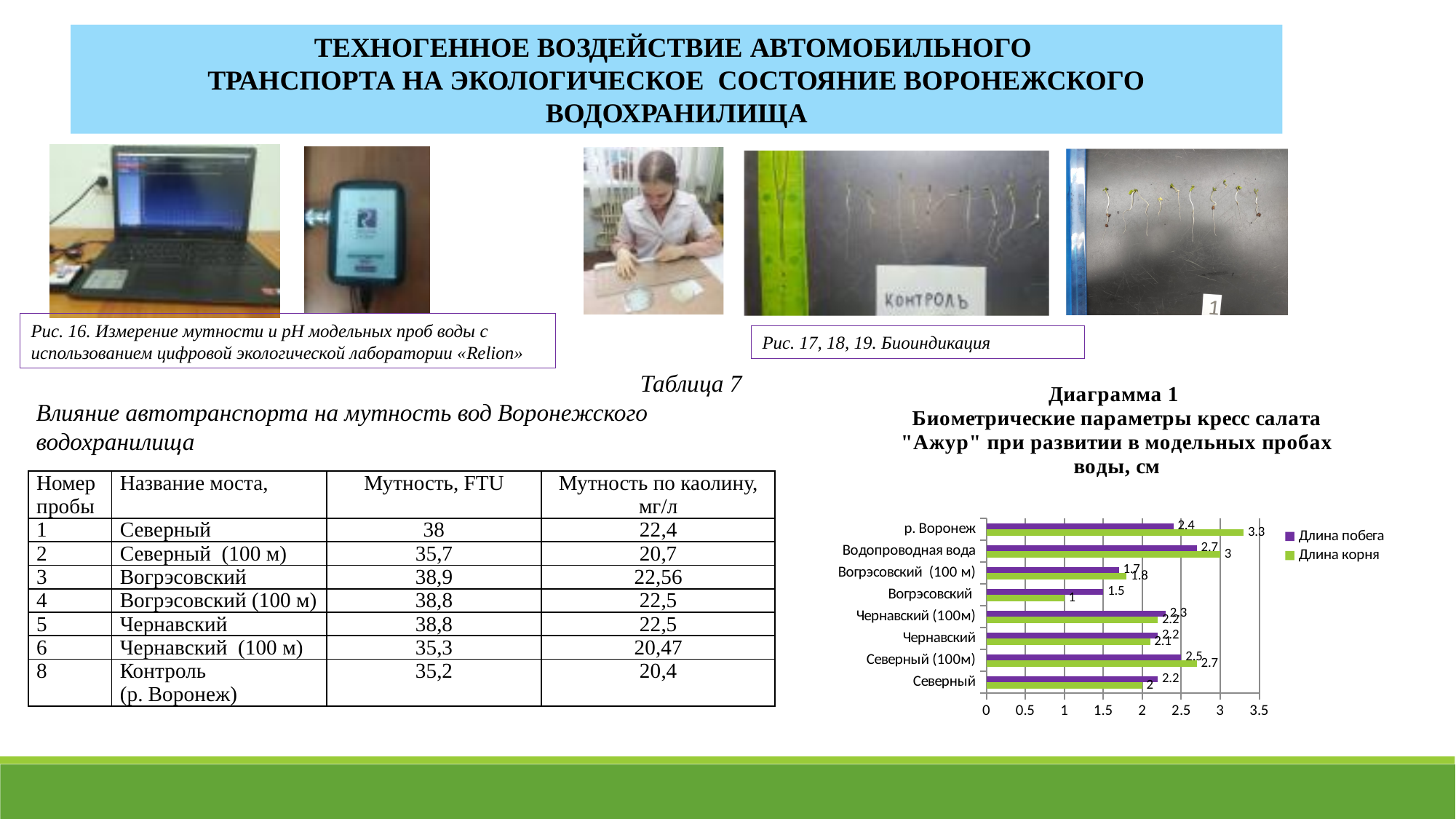
How many categories are shown on the y axis of Диаграмма 1? 8 In Диаграмма 1, which colour represents Длина побега? purple In Диаграмма 1, what is the difference between Длина корня and Длина побега for р. Воронеж? 0.9 In Диаграмма 1, which is larger for Северный (100м): Длина побега or Длина корня? Длина корня In Диаграмма 1, what is the value of Длина корня for Вогрэсовский? 1 In Диаграмма 1, which category has the lowest value of Длина побега? Вогрэсовский In Диаграмма 1, is the value of Длина корня for Водопроводная вода greater or less than 2.5? greater In Диаграмма 1, what is the value of Длина побега for Водопроводная вода? 2.7 In Диаграмма 1, what is the value of Длина корня for р. Воронеж? 3.3 In Диаграмма 1, which category has the highest value of Длина корня? р. Воронеж How many series does the legend of Диаграмма 1 list? 2 What kind of chart is Диаграмма 1? bar chart